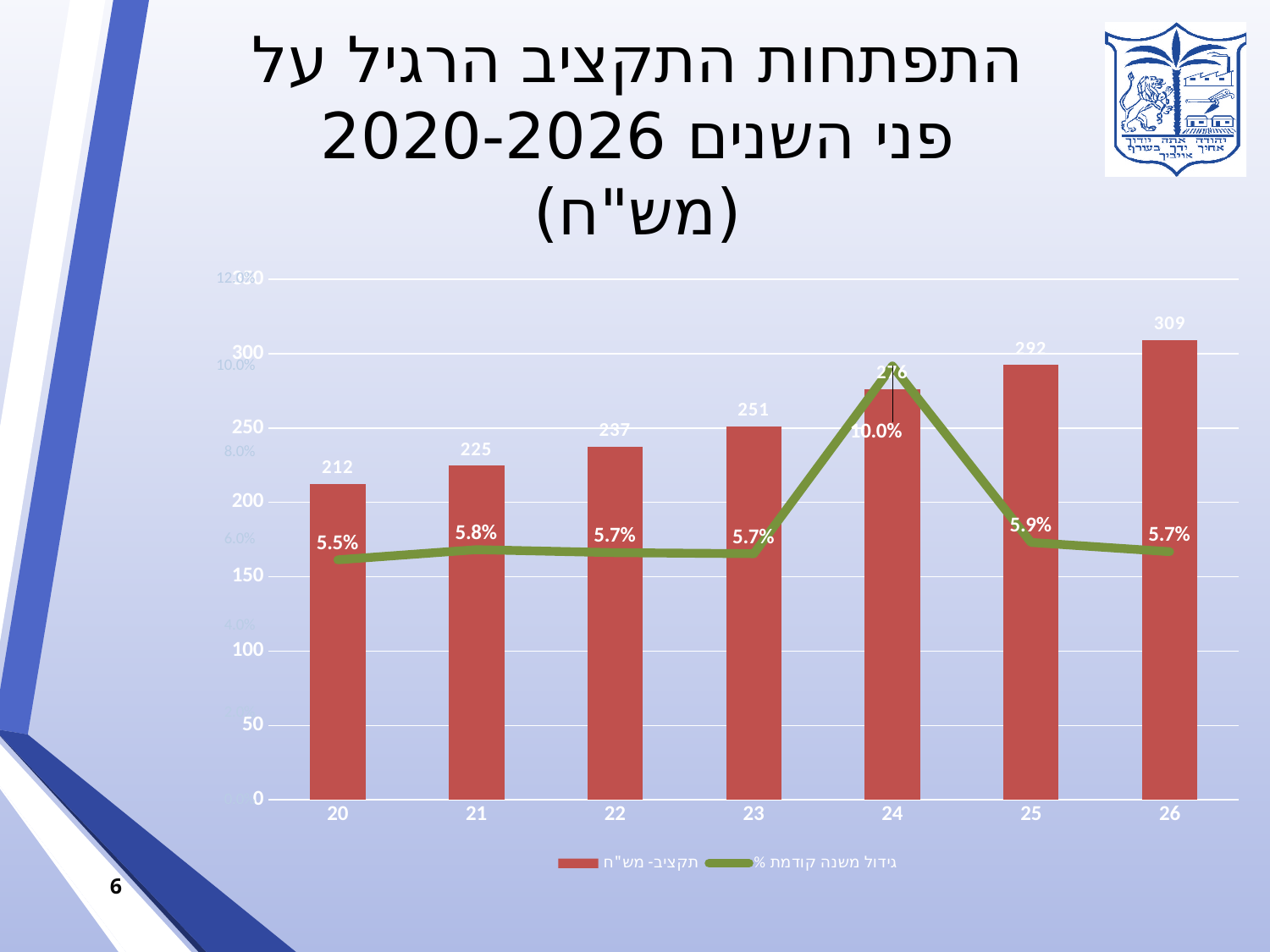
Which year has the highest growth percentage from the previous year? 24 Do the budget bar values rise or fall from year 20 to year 26? rise How many series does the legend list? 2 What is the budget value (תקציב- מש"ח) for year 20? 212 Which year has the lowest budget value? 20 Which year has the highest budget value? 26 What is the growth from previous year (גידול משנה קודמת %) for year 21? 5.8% What is the difference between the budget values for year 26 and year 20? 97 What is the budget value (תקציב- מש"ח) for year 26? 309 What is the growth from previous year (גידול משנה קודמת %) for year 24? 10.0% How many years are shown on the x axis? 7 Which is larger, the budget value for year 23 or for year 22? year 23